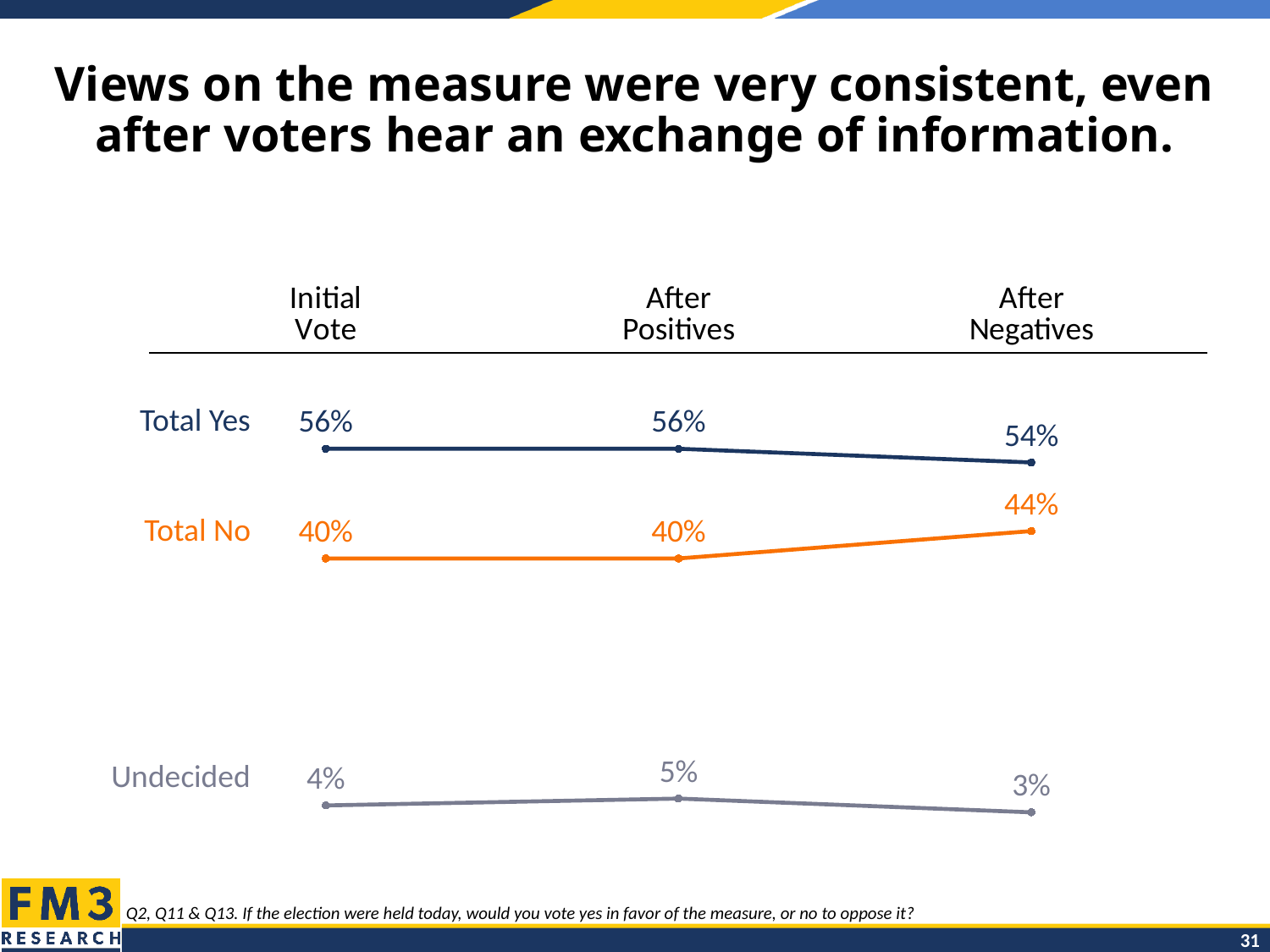
What kind of chart is shown on the slide? Line chart Which is larger After Positives, Total Yes or Total No? Total Yes How many points along the x axis does the chart show? 3 What is the Total Yes value at the Initial Vote? 56% Does the Total No line rise or fall from After Positives to After Negatives? Rise At which point is the Total No value highest? After Negatives What is the difference between Total Yes and Total No After Negatives? 10% What is the Total No value After Negatives? 44% At which point is the Undecided value lowest? After Negatives How many series are plotted on the chart? 3 What is the Undecided value After Positives? 5% What is the Total Yes value After Negatives? 54%